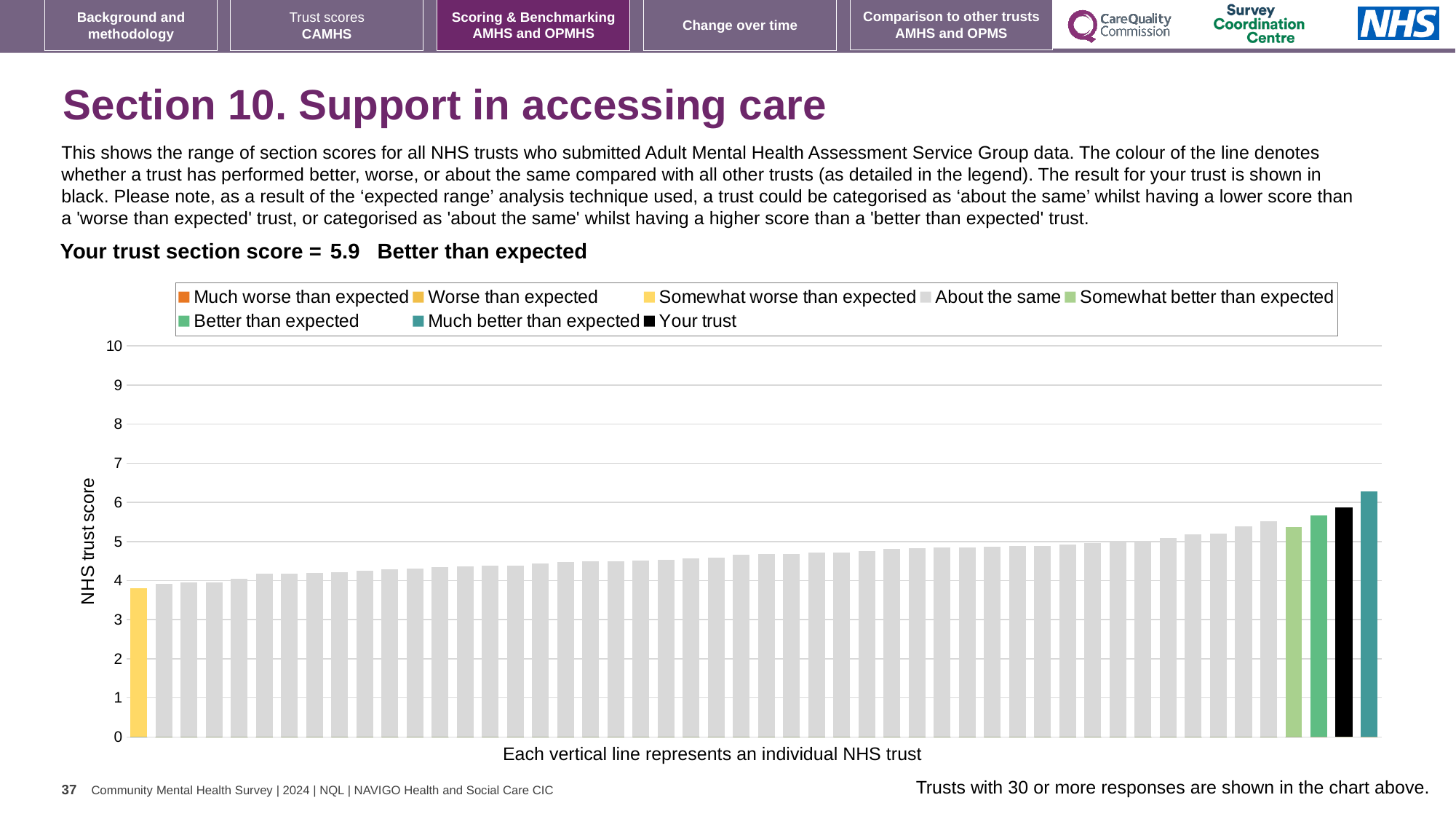
How many entries does the chart legend list? 8 Is the value of the black 'Your trust' bar greater or less than 5? greater Is the value of the rightmost (teal) bar greater or less than 6? greater What kind of chart is shown on the slide? Bar chart Which performance category is your trust's section score placed in? Better than expected Do the bar values rise or fall from left to right along the x axis? rise What is the label on the y axis of the chart? NHS trust score Which bar is the lowest in the chart? The leftmost bar (Somewhat worse than expected) Which bar is the highest in the chart? The rightmost bar (Much better than expected) Is the value of the leftmost (yellow) bar greater or less than 5? less What is the section score for your trust? 5.9 Which is larger: the 'Your trust' bar or the rightmost teal bar? The rightmost teal bar